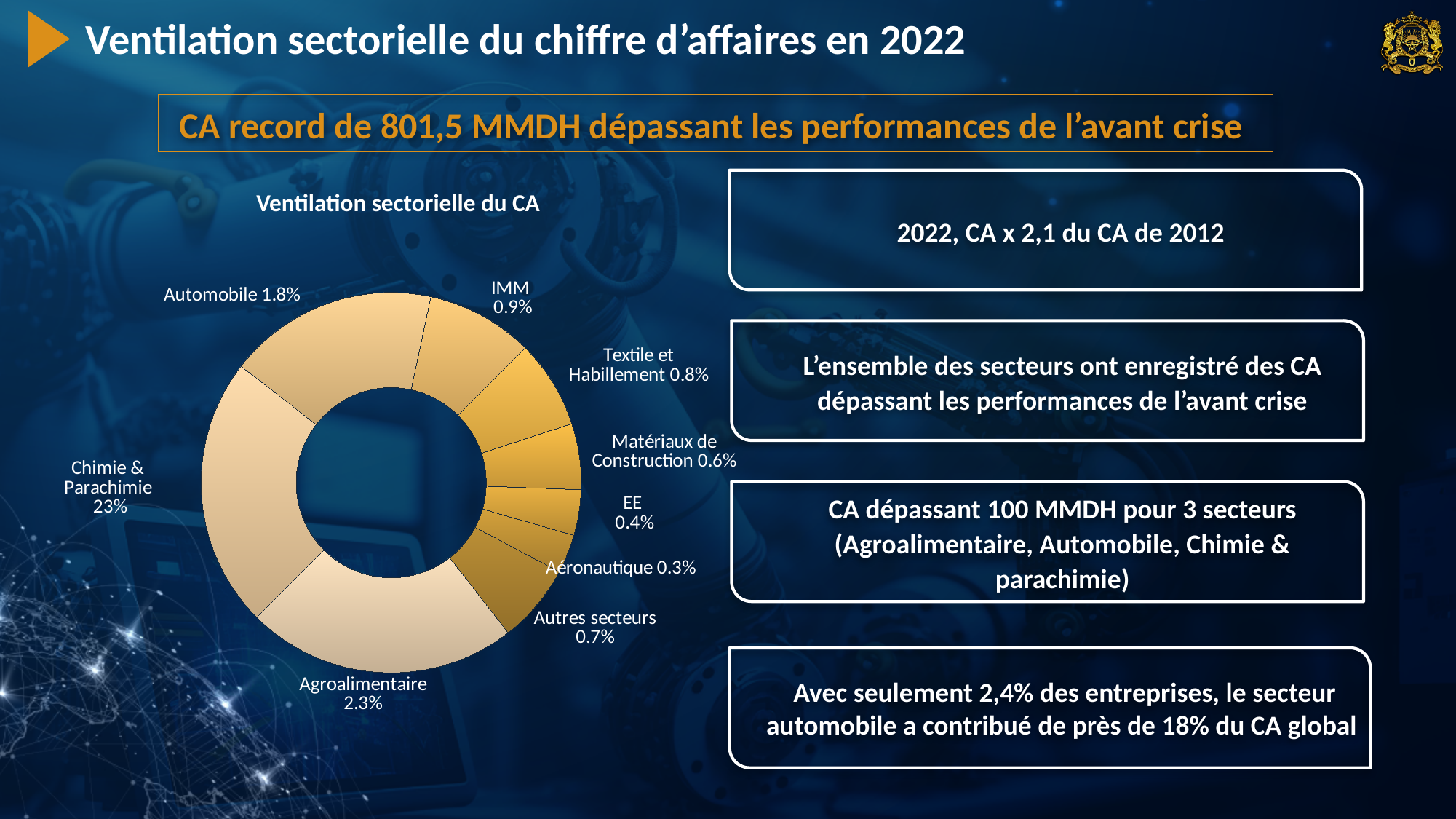
What value is shown for Automobile in the chart? 1.8% Which sector has the highest labelled value in the chart? Chimie & Parachimie How many sectors (slices) are shown in the chart? 9 What value is shown for Chimie & Parachimie in the chart? 23% What is the title of the chart on the slide? Ventilation sectorielle du CA Which sector has the lowest labelled value in the chart? Aéronautique What value is shown for Autres secteurs in the chart? 0.7% What kind of chart is shown on the slide? Pie chart (doughnut) What value is shown for Agroalimentaire in the chart? 2.3% What value is shown for Textile et Habillement in the chart? 0.8% What value is shown for Aéronautique in the chart? 0.3% What is the difference between the labelled values for Agroalimentaire and Automobile? 0.5%